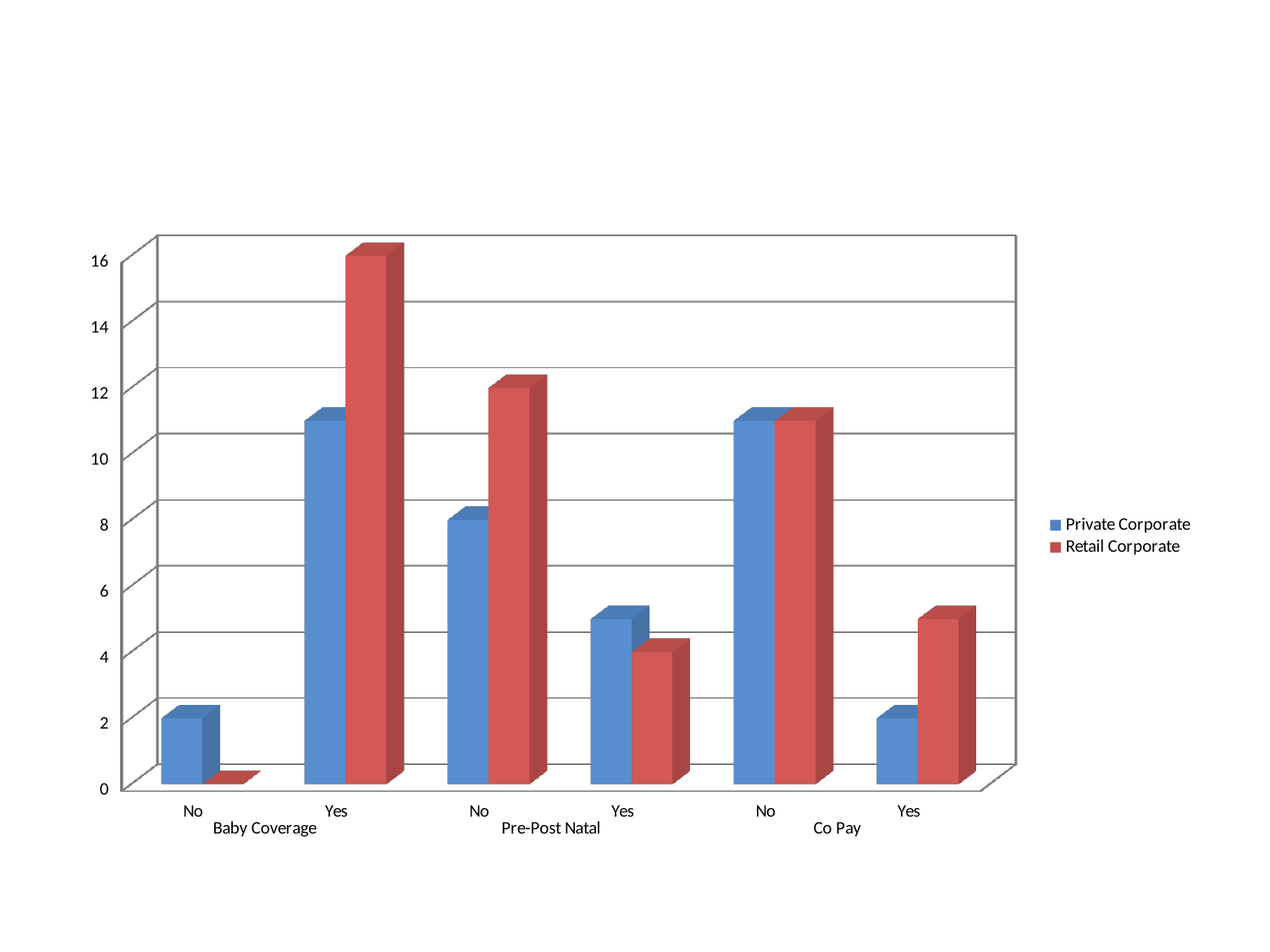
Which series has the tallest bar on the chart, and for which category? Retail Corporate, Baby Coverage Yes For Pre-Post Natal No, which series has the larger value, Private Corporate or Retail Corporate? Retail Corporate What is the Retail Corporate value for Pre-Post Natal No? 12 What is the Private Corporate value for Pre-Post Natal No? 8 Is the Retail Corporate value for Co Pay Yes greater or less than 4? greater Is the Private Corporate value for Baby Coverage Yes greater or less than 10? greater For Baby Coverage No, which series has the larger value, Private Corporate or Retail Corporate? Private Corporate What are the two series named in the legend? Private Corporate and Retail Corporate What kind of chart is shown on the slide? bar chart What is the Retail Corporate value for Baby Coverage Yes? 16 How many series does the legend list? 2